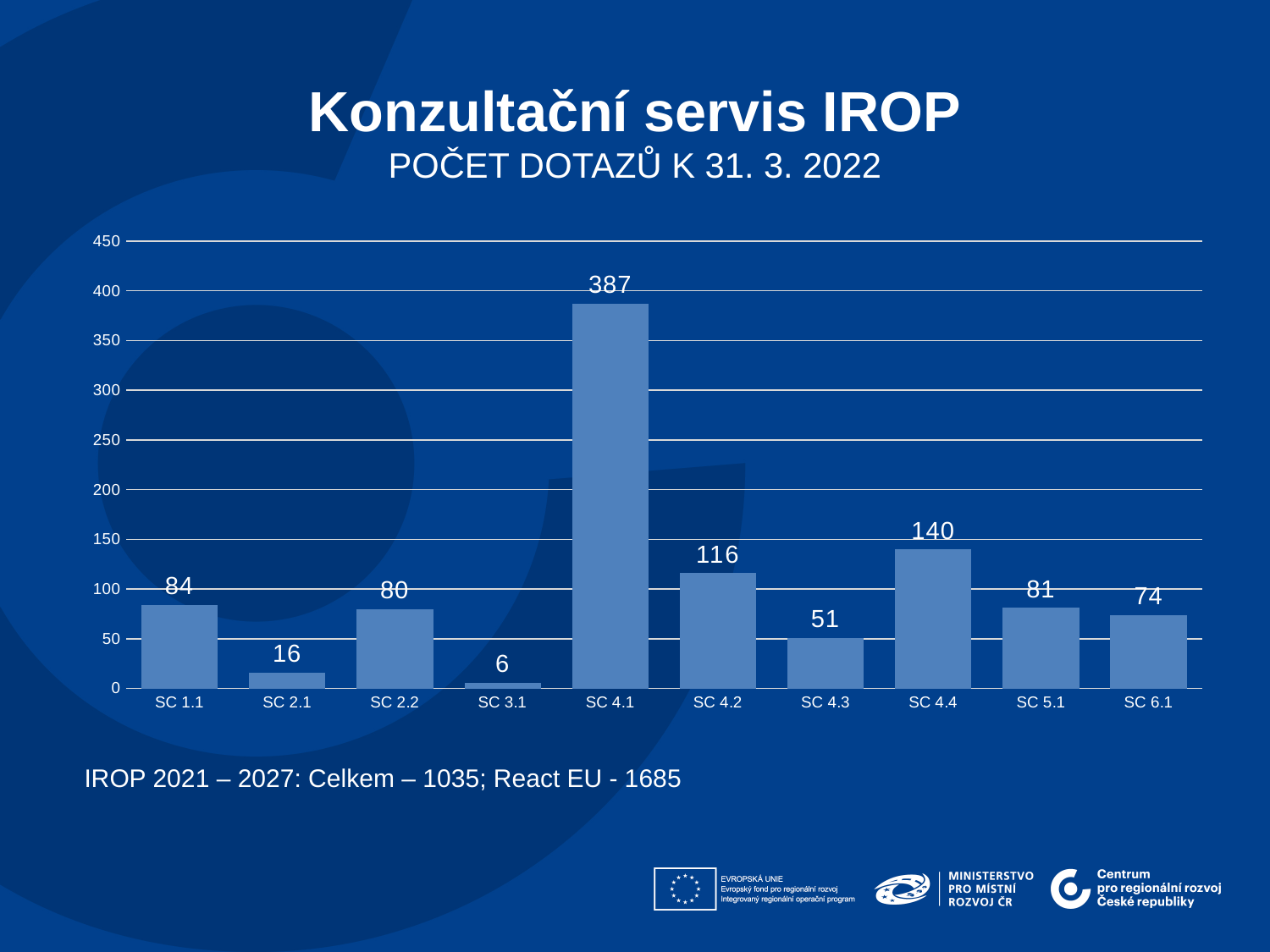
What is the value for SC 4.1? 387 Which is larger, the value for SC 4.3 or the value for SC 6.1? SC 6.1 What is the value for SC 2.1? 16 What is the subtitle shown above the chart? POČET DOTAZŮ K 31. 3. 2022 Which category has the lowest value? SC 3.1 How many categories are shown on the x axis? 10 What is the difference between the values for SC 4.1 and SC 4.2? 271 What is the value for SC 4.4? 140 What is the difference between the values for SC 1.1 and SC 2.2? 4 Is the value for SC 4.2 greater or less than 100? greater What kind of chart is shown on the slide? bar chart Which category has the highest value? SC 4.1